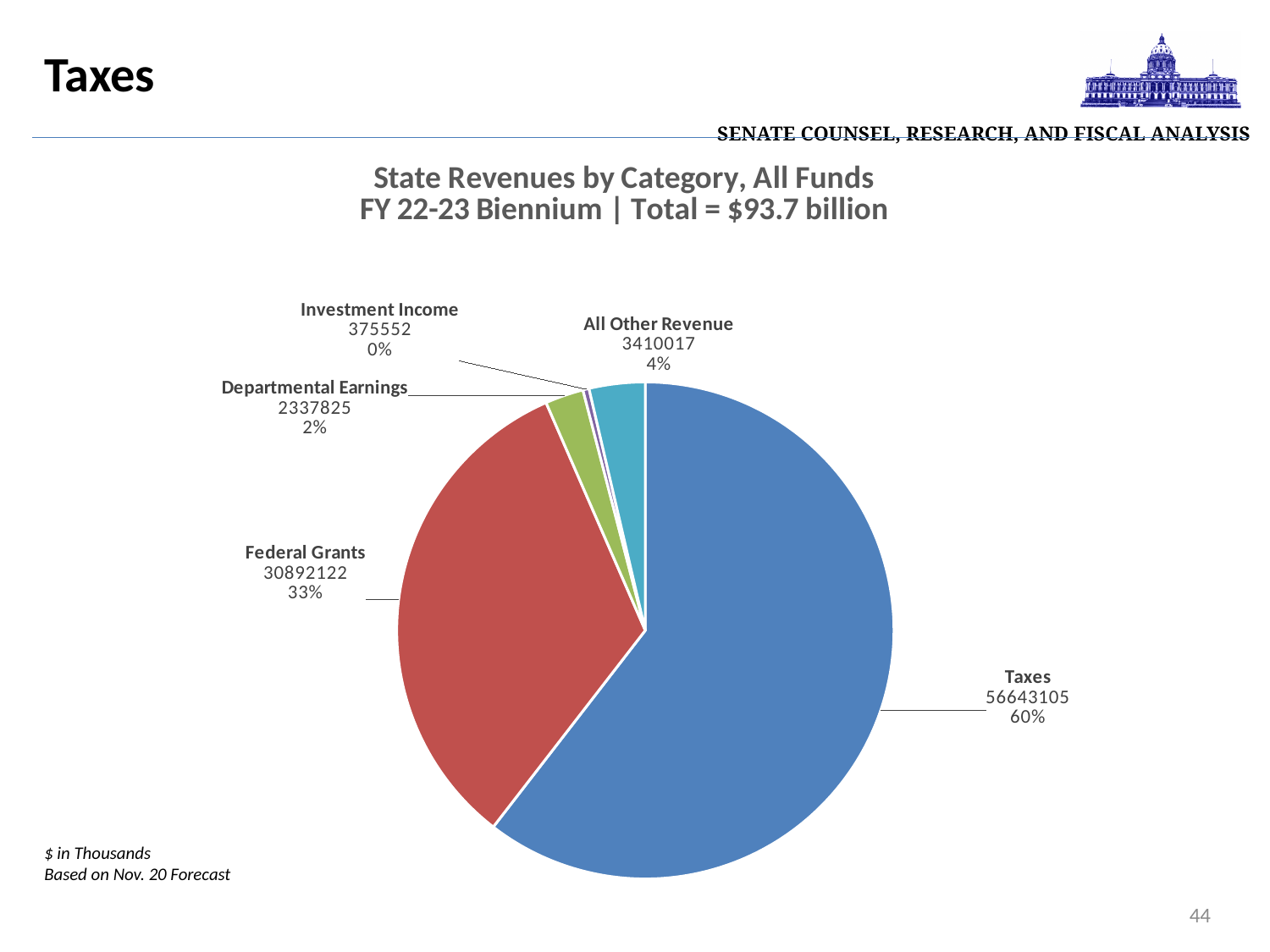
How many categories are shown in the pie chart? 5 What type of chart is shown on the slide? Pie chart Which category has the largest slice? Taxes Which category has the smallest slice? Investment Income What share of the pie does Federal Grants represent? 33% What share of the pie does All Other Revenue represent? 4% What is the value for Federal Grants? 30892122 What is the value for Investment Income? 375552 What is the value for Taxes? 56643105 What is the difference between the values for All Other Revenue and Departmental Earnings? 1072192 Which is larger, Departmental Earnings or All Other Revenue? All Other Revenue What is the difference between the values for Taxes and Federal Grants? 25750983